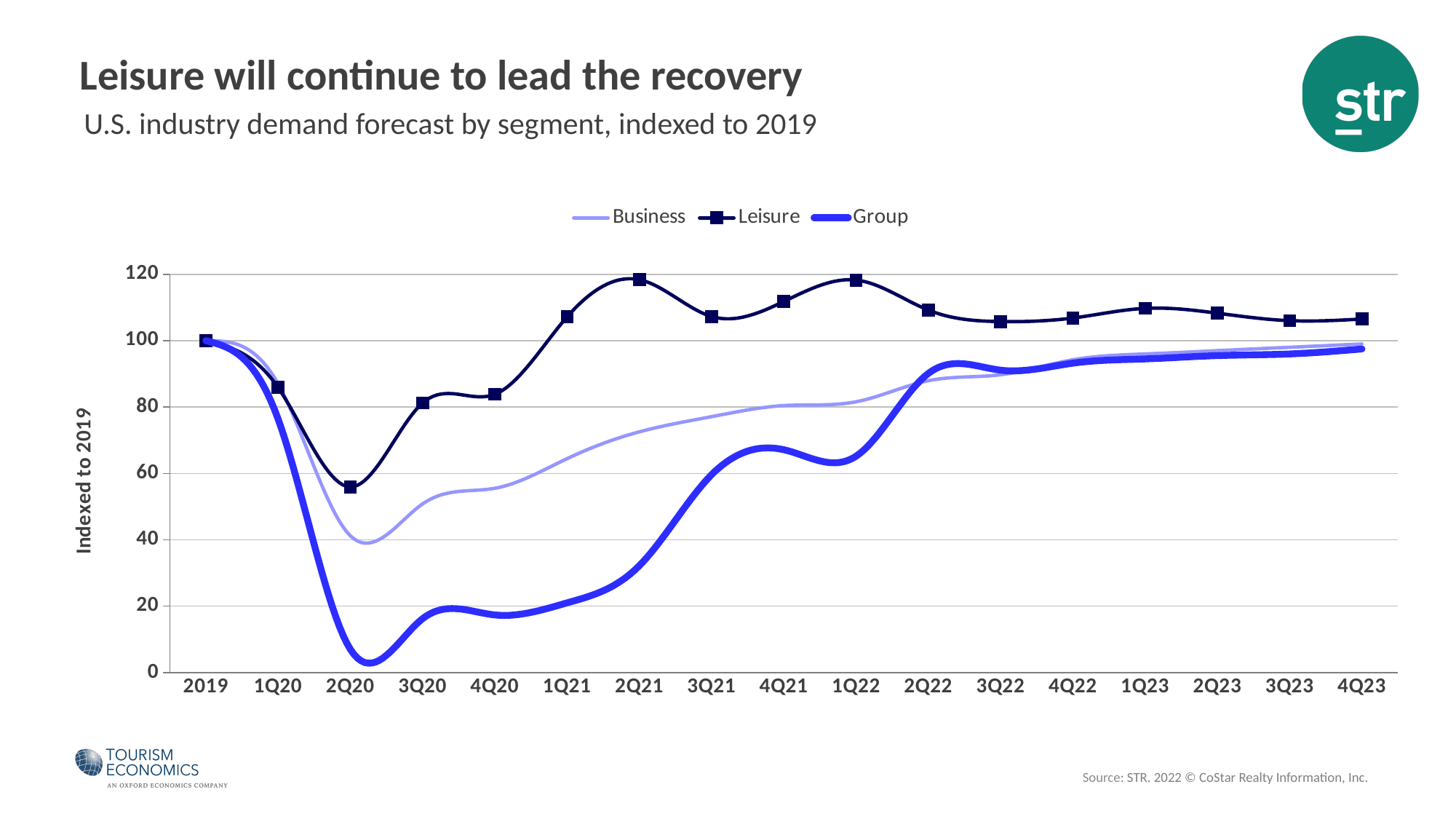
What is the value for Leisure at 2019? 100 What kind of chart is shown on the slide? line chart Is the value for Group at 2Q20 greater or less than 20? less How many points are shown along the x axis? 17 Is the value for Leisure at 2Q21 greater or less than 100? greater What is the label on the y axis? Indexed to 2019 Is the value for Group at 1Q22 greater or less than 80? less Which series has the highest value at 4Q23? Leisure At 4Q21, which is larger: Leisure or Group? Leisure How many series does the legend list? 3 Which series has the lowest value at 2Q20? Group